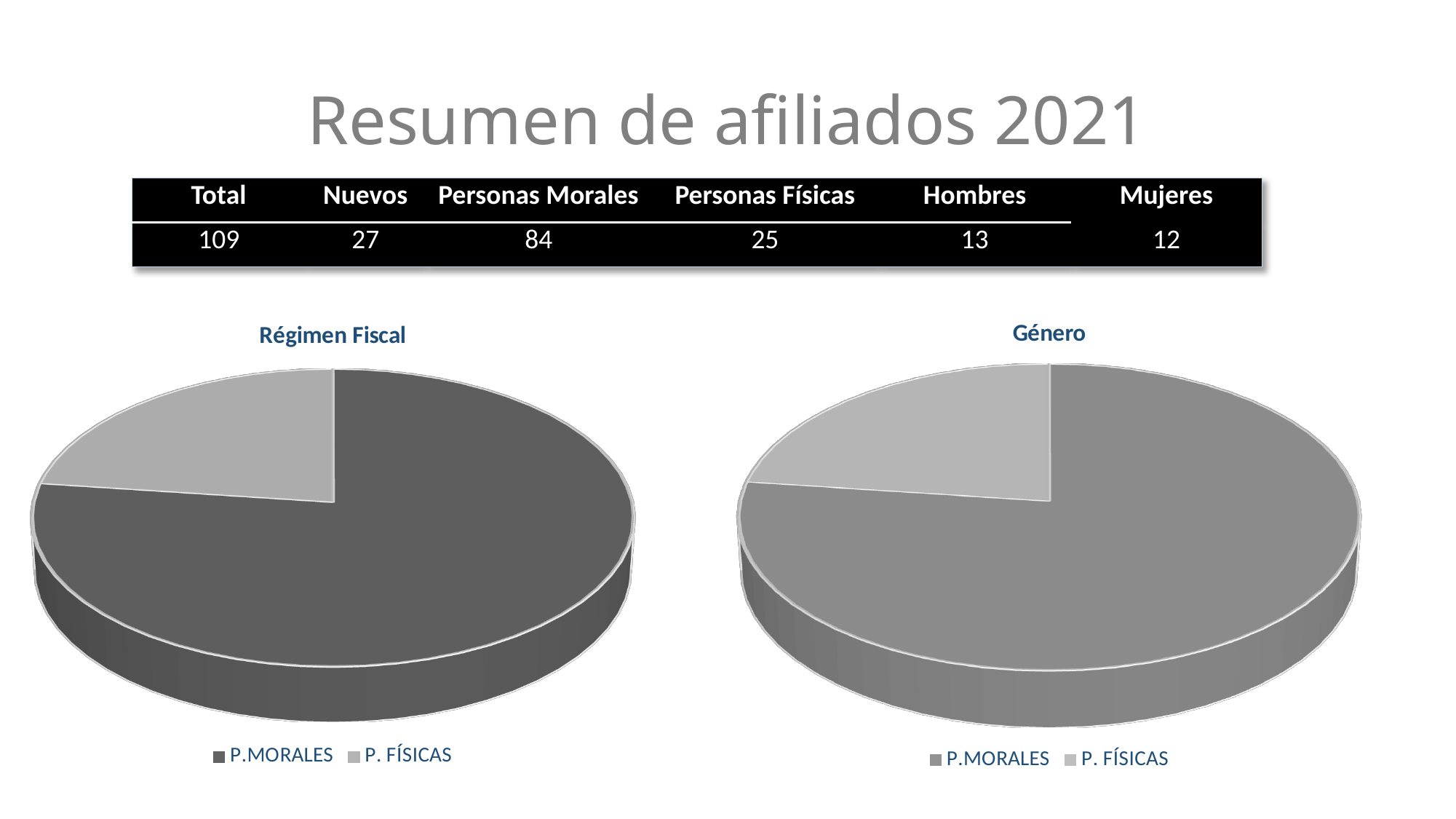
In the "Régimen Fiscal" chart, how many slices does the pie have? 2 In the "Régimen Fiscal" chart, which slice is the smallest? P. FÍSICAS What kind of chart is the "Régimen Fiscal" chart? Pie chart What kind of chart is the "Género" chart? Pie chart In the "Género" chart, which slice is the largest? P.MORALES In the "Régimen Fiscal" chart, which is larger, P.MORALES or P. FÍSICAS? P.MORALES What is the title of the pie chart on the left of the slide? Régimen Fiscal In the "Género" chart, how many slices does the pie have? 2 In the "Género" chart, which slice is the smallest? P. FÍSICAS How many entries does the legend of the "Régimen Fiscal" chart list? 2 What is the title of the pie chart on the right of the slide? Género In the "Régimen Fiscal" chart, which slice is the largest? P.MORALES